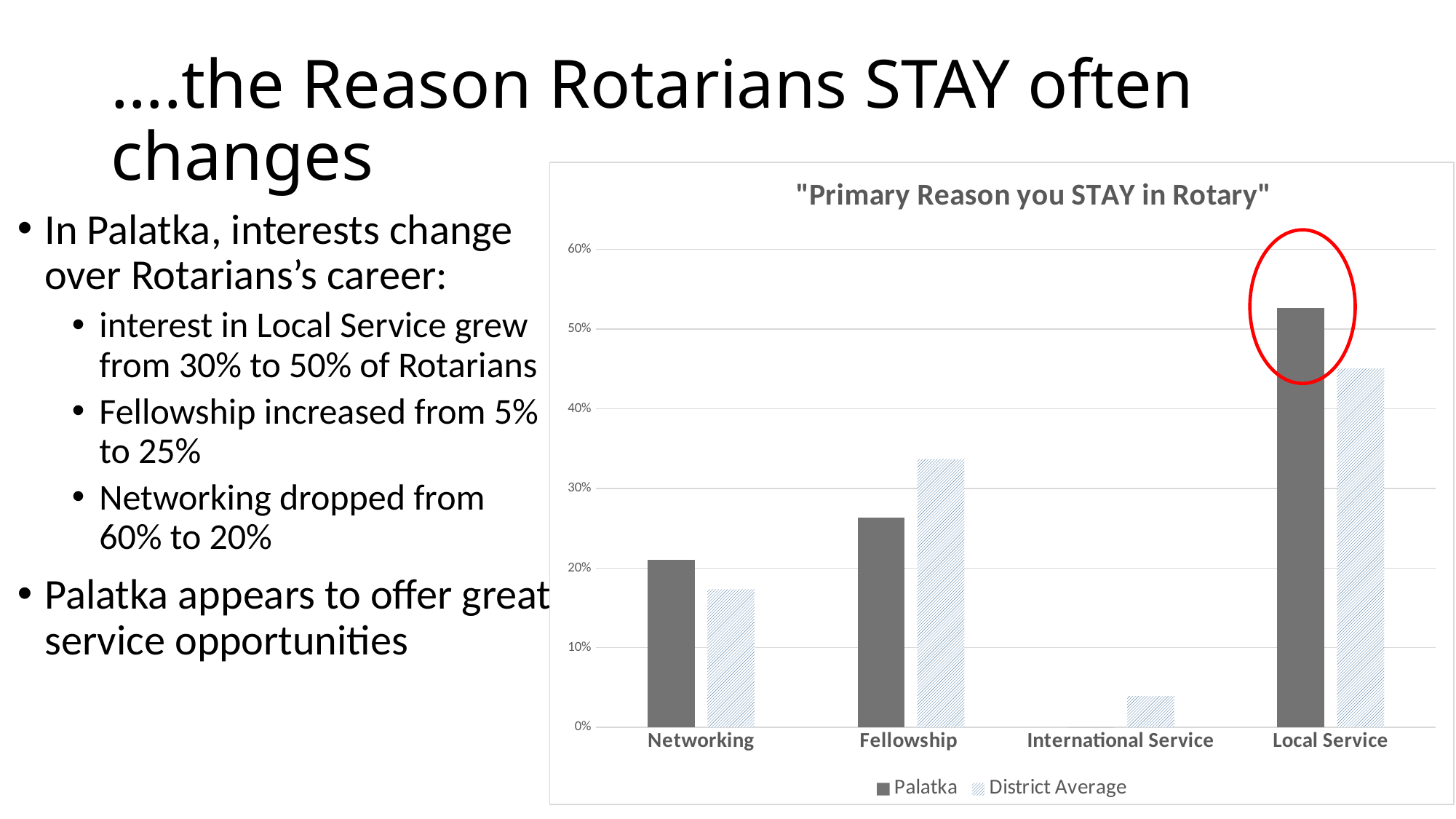
Which category has the highest value for the District Average series? Local Service Is the District Average value for Fellowship greater or less than 30%? greater For Fellowship, which series has the larger value, Palatka or District Average? District Average How many categories are shown on the x axis of the chart? 4 Which category has the lowest value for the Palatka series? International Service Which category has the lowest value for the District Average series? International Service Which category has the highest value for the Palatka series? Local Service Is the Palatka value for Local Service greater or less than 40%? greater How many series does the chart legend list? 2 What is the title of the chart? "Primary Reason you STAY in Rotary" What type of chart is shown on the slide? bar chart For Local Service, which series has the larger value, Palatka or District Average? Palatka